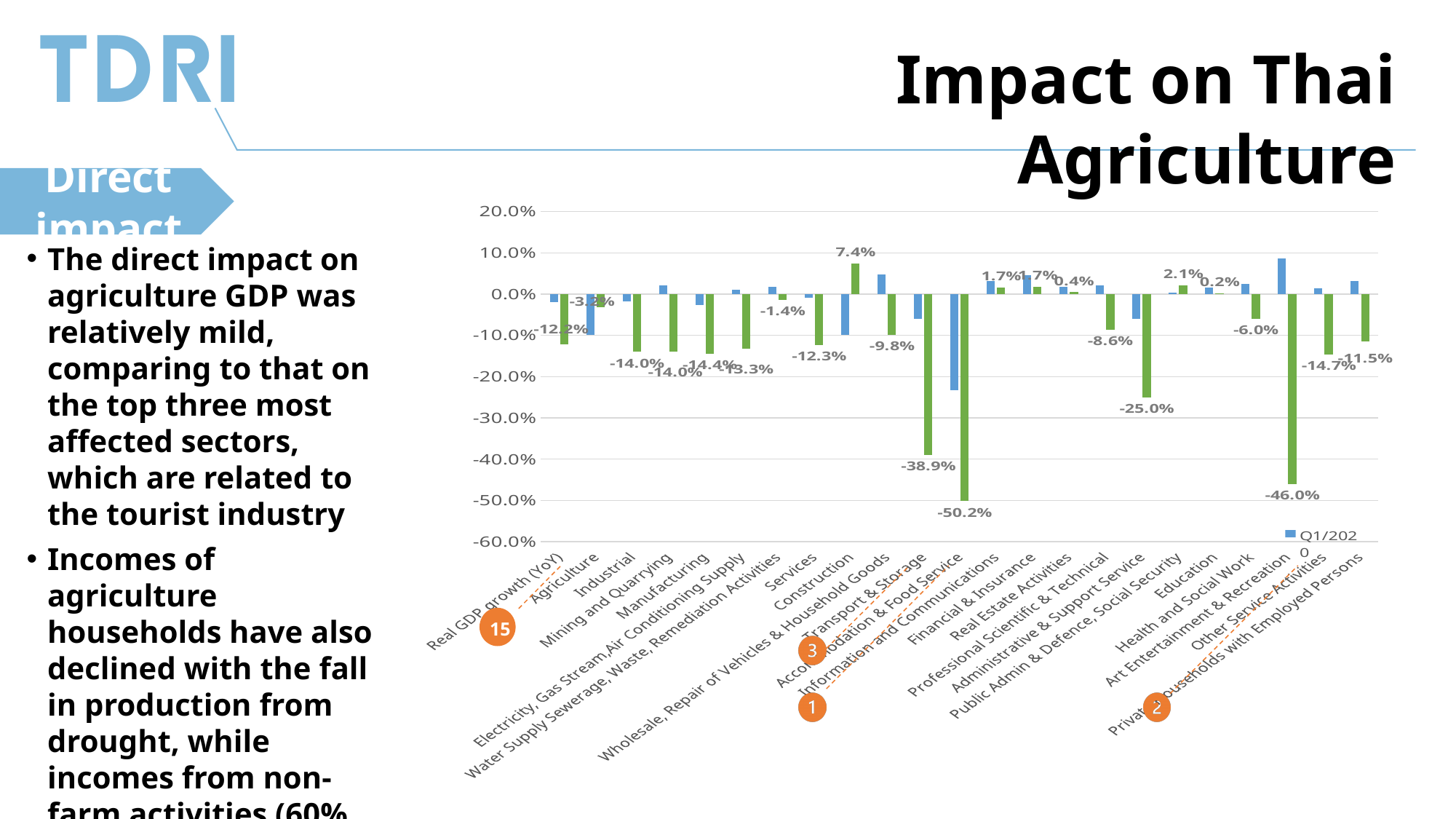
What kind of chart is shown on the slide? bar chart What colour are the bars for the Q1/2020 series in the legend? blue What is the green bar value for Art Entertainment & Recreation? -46.0% What is the green bar value for Transport & Storage? -38.9% How many categories are shown on the x axis of the chart? 23 Which category has the lowest green bar value? Accommodation & Food Service Which category has the highest green bar value? Construction Is the blue (Q1/2020) bar value for Accommodation & Food Service greater or less than -20.0%? less What is the green bar value for Administrative & Support Service? -25.0% What is the green bar value for Accommodation & Food Service? -50.2% Which green bar value is larger: Transport & Storage or Administrative & Support Service? Administrative & Support Service What is the difference between the green bar values for Accommodation & Food Service (-50.2%) and Art Entertainment & Recreation (-46.0%)? 4.2 percentage points